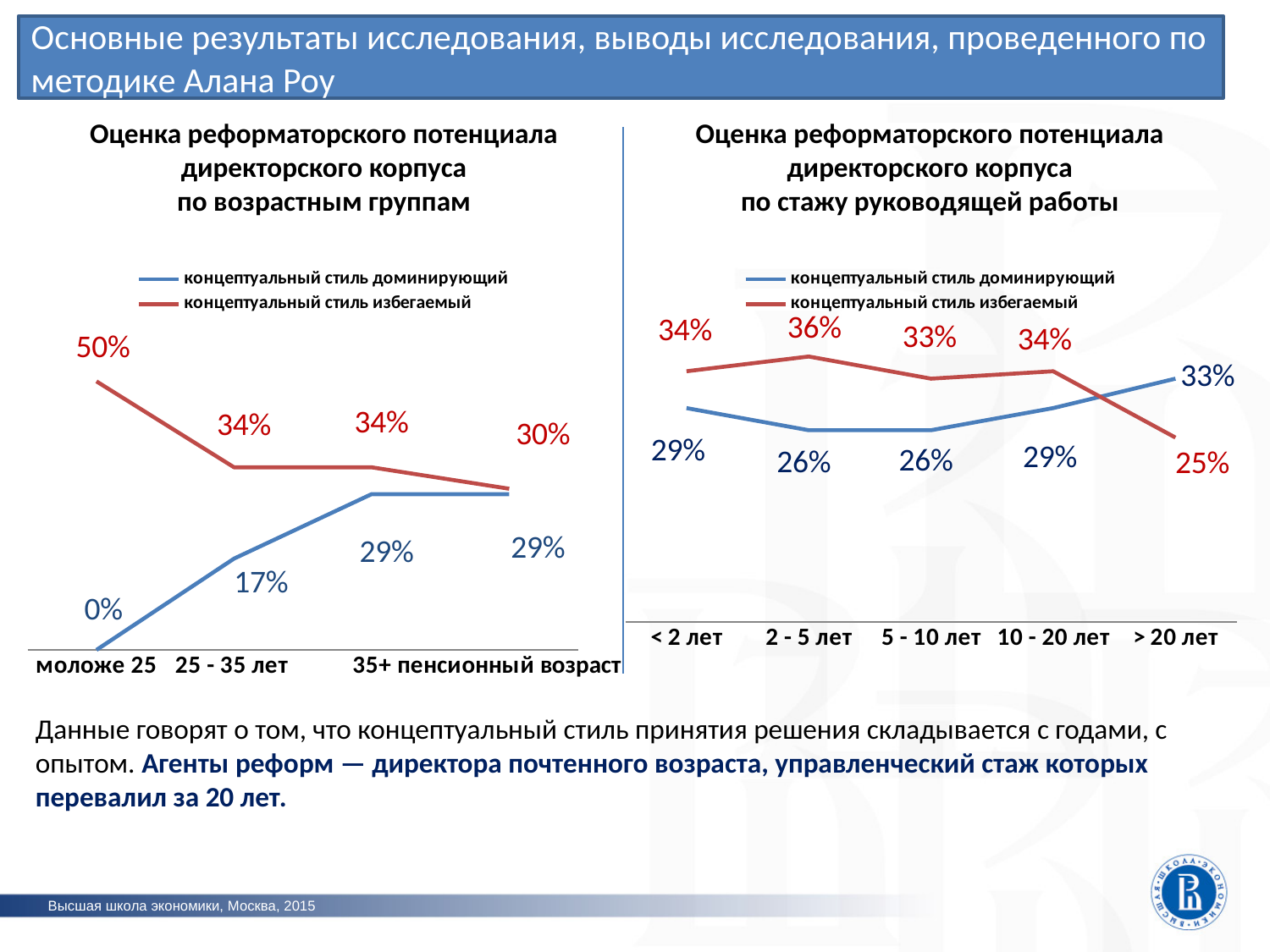
What type of chart is the right chart (по стажу руководящей работы)? line chart On the right chart (по стажу руководящей работы), what is the value of концептуальный стиль избегаемый for 2 - 5 лет? 36% On the left chart (по возрастным группам), which age group has the lowest value for концептуальный стиль доминирующий? моложе 25 On the right chart (по стажу руководящей работы), how many categories are shown on the x axis? 5 On the left chart (по возрастным группам), what is the value of концептуальный стиль доминирующий for 25 - 35 лет? 17% On the right chart (по стажу руководящей работы), what is the value of концептуальный стиль доминирующий for > 20 лет? 33% On the left chart (по возрастным группам), what is the difference between концептуальный стиль избегаемый and концептуальный стиль доминирующий for моложе 25? 50% On the left chart (по возрастным группам), how many series does the legend list? 2 On the right chart (по стажу руководящей работы), which category has the highest value for концептуальный стиль доминирующий? > 20 лет On the left chart (по возрастным группам), what is the value of концептуальный стиль избегаемый for моложе 25? 50% On the right chart (по стажу руководящей работы), which is larger for > 20 лет: концептуальный стиль доминирующий or концептуальный стиль избегаемый? концептуальный стиль доминирующий On the left chart (по возрастным группам), does концептуальный стиль доминирующий rise or fall from моложе 25 to 35+? rise